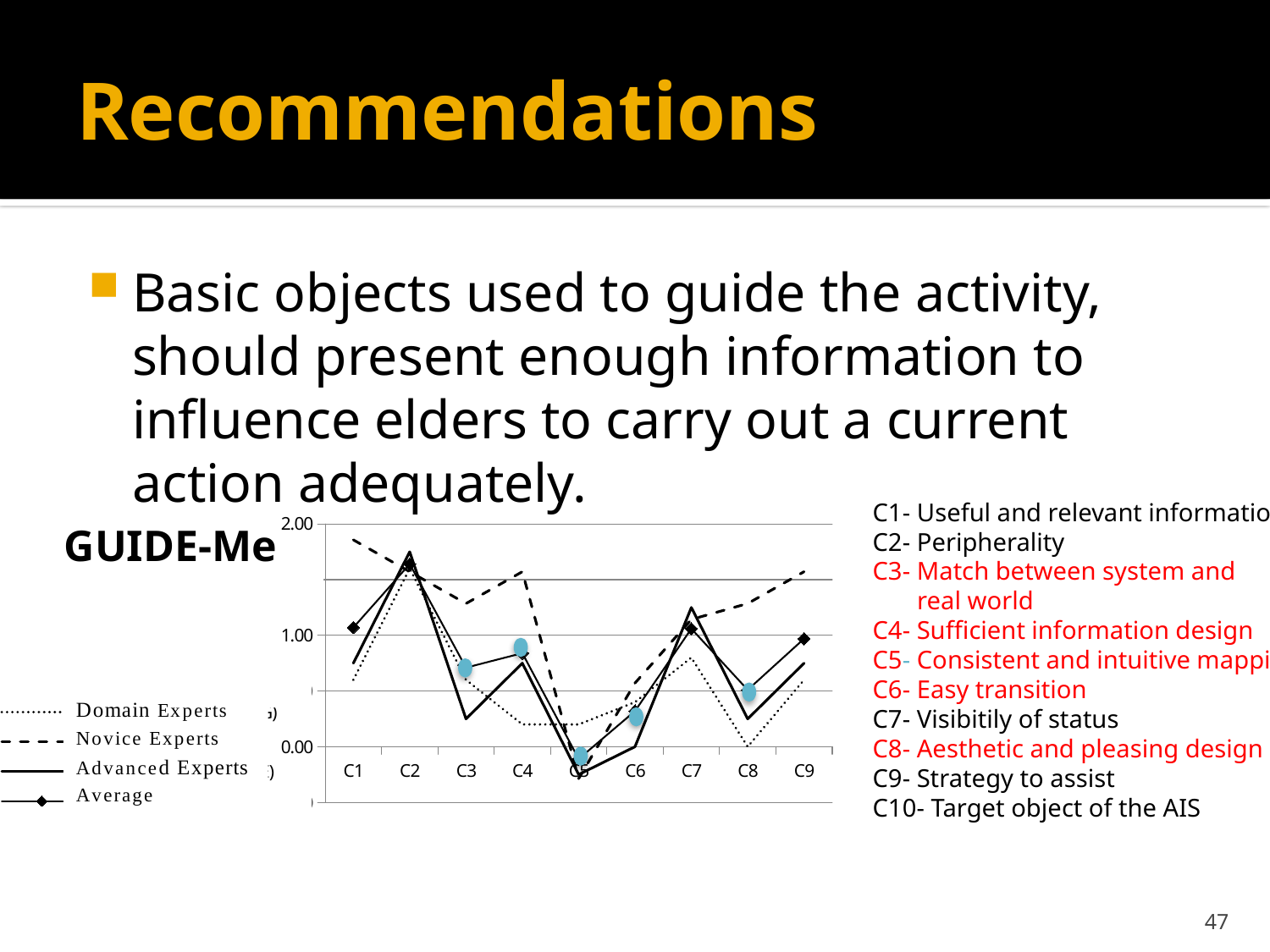
Is the Novice Experts value for C1 greater or less than 1.00? greater What kind of chart is shown on the slide? line chart Is the Average value for C2 greater or less than 1.00? greater Is the Average value for C5 greater or less than 1.00? less Which series are listed in the chart's legend? Domain Experts, Novice Experts, Advanced Experts, Average Which is larger for the Average series, the value at C2 or the value at C6? C2 Does the Average series rise or fall from C1 to C2? rise For the Average series, which category has the lowest value? C5 For the Average series, which category has the highest value? C2 How many series does the chart's legend list? 4 How many categories are shown on the x axis of the chart? 9 Which series in the legend is drawn with a dotted line? Domain Experts